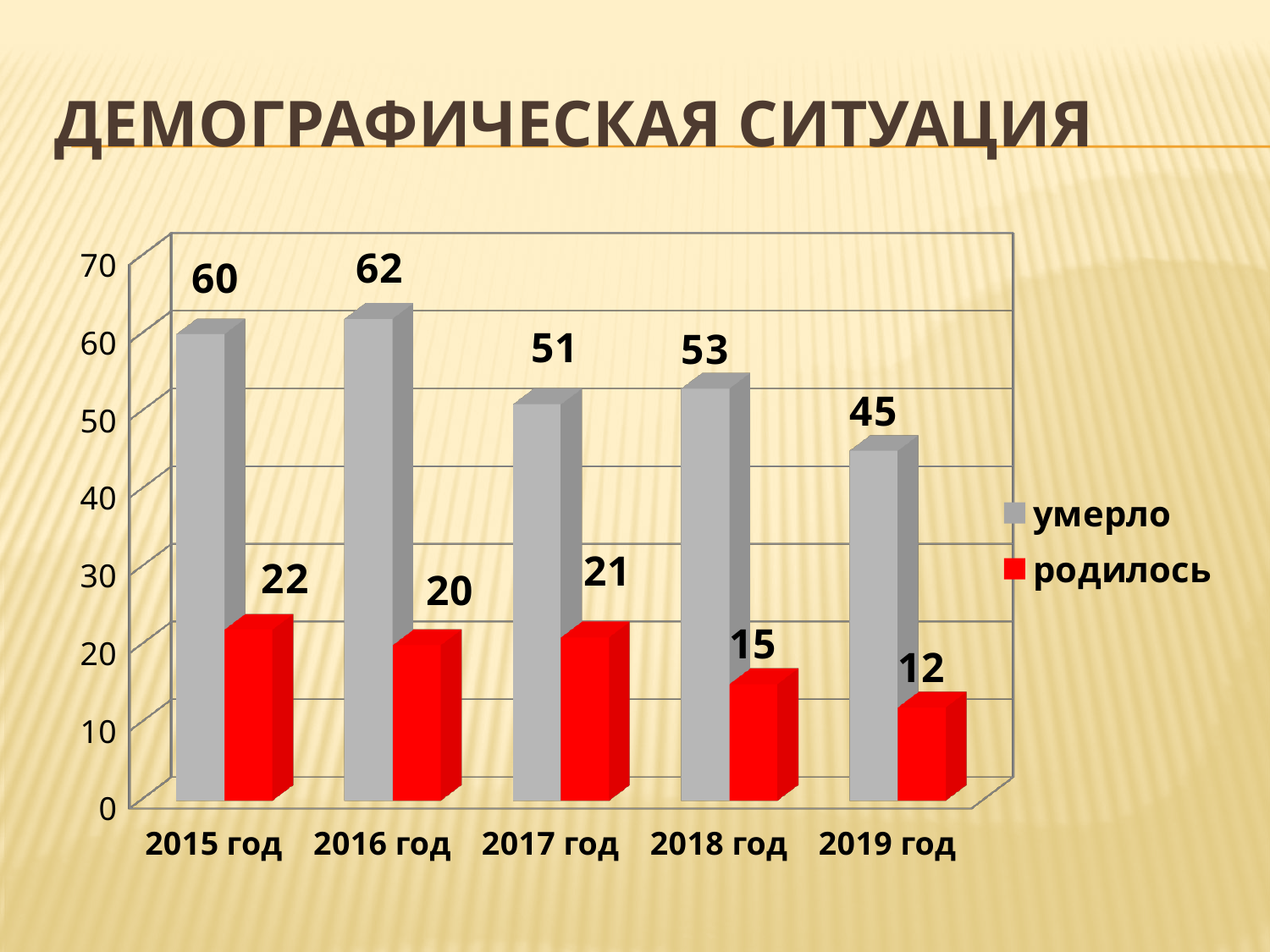
How many years are shown on the x axis? 5 Is the value for умерло in 2015 год greater or less than 50? greater What is the value for родилось in 2018 год? 15 Which year has the highest value for умерло? 2016 год What is the difference between умерло and родилось in 2019 год? 33 Which year has the lowest value for родилось? 2019 год How many series does the legend list? 2 What colour are the bars for родилось? red Which is larger: умерло in 2017 год or умерло in 2018 год? умерло in 2018 год What is the value for умерло in 2016 год? 62 What kind of chart is shown on the slide? bar chart Do the values for родилось rise or fall from 2017 год to 2019 год? fall